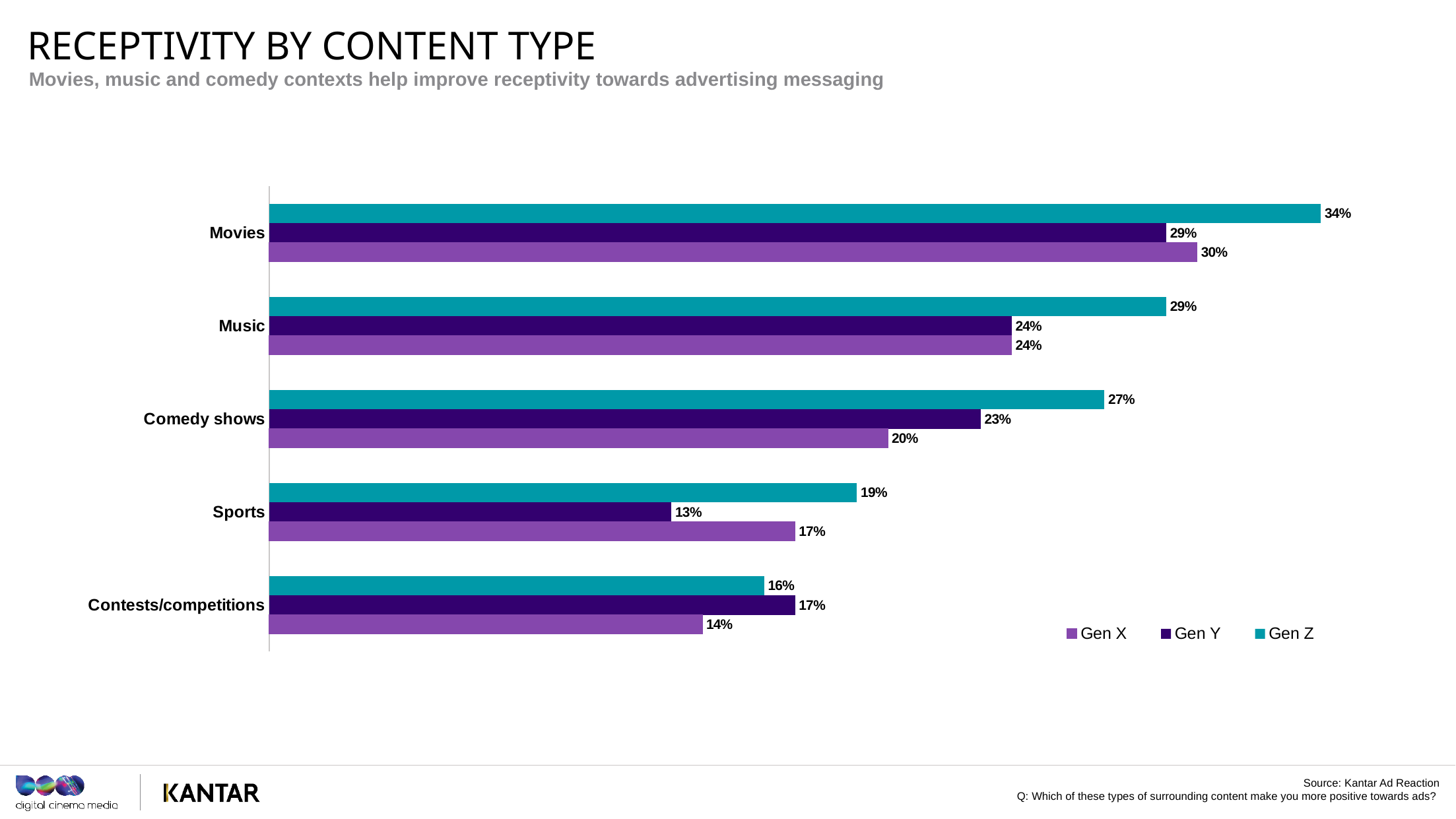
What is the difference between the Gen Z values for Movies and Music? 5% What is the Gen X value for Contests/competitions? 14% Which is larger for Contests/competitions, the Gen Y value or the Gen Z value? Gen Y How many content types are shown on the chart? 5 Which series is shown in teal in the legend? Gen Z What is the difference between the Gen Z and Gen X values for Comedy shows? 7% What kind of chart is shown on the slide? Bar chart How many series does the legend list? 3 Which content type has the lowest Gen X value? Contests/competitions Which content type has the highest Gen Z value? Movies What is the Gen Y value for Sports? 13% What is the Gen Z value for Movies? 34%